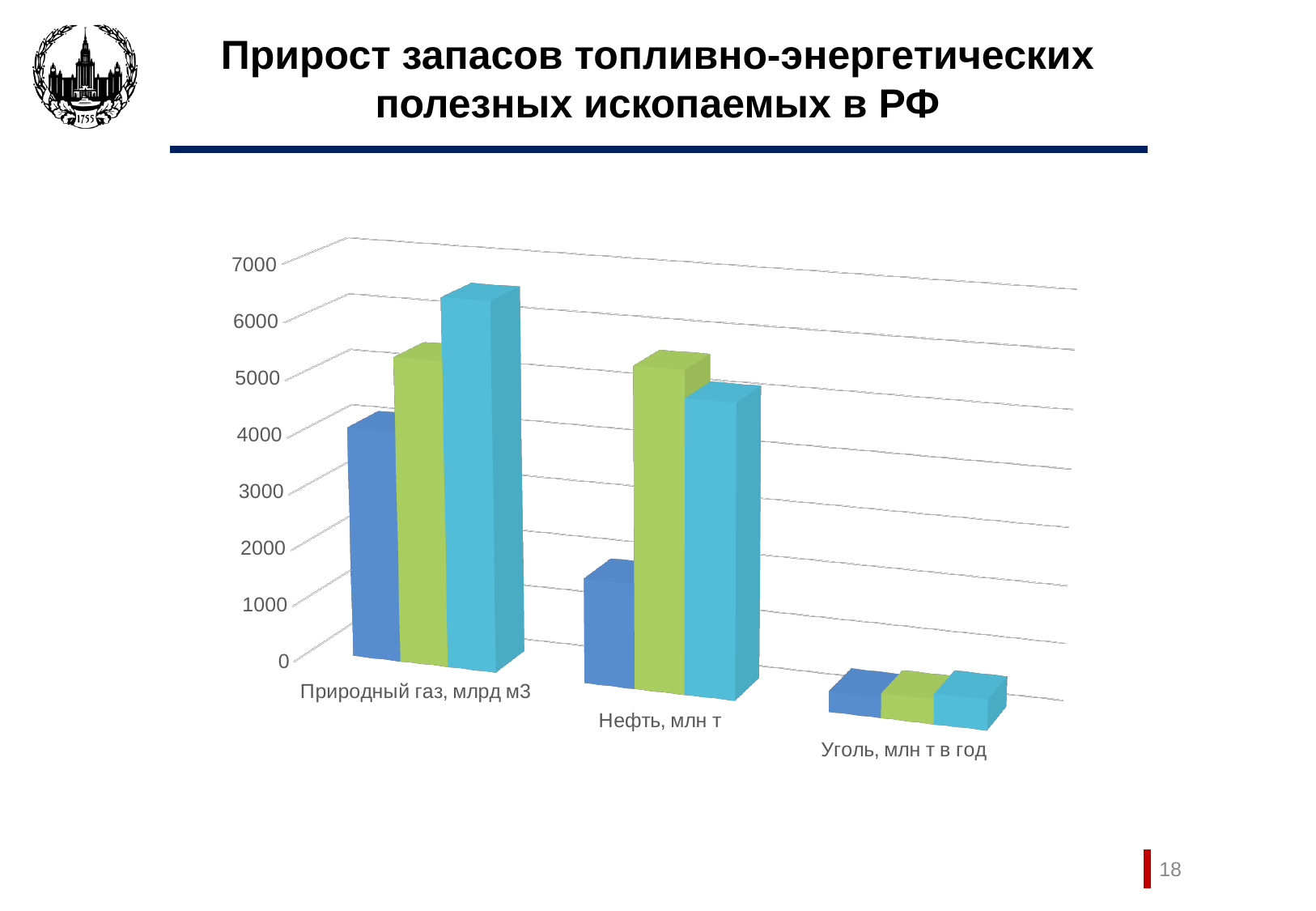
Is the value of the first (blue) bar for Нефть, млн т greater or less than 2000? less Which category has the lowest bars in the chart? Уголь, млн т в год What is the title of the slide containing the chart? Прирост запасов топливно-энергетических полезных ископаемых в РФ How many categories are shown on the x axis of the chart? 3 Is the value of the second (green) bar for Нефть, млн т greater or less than 4000? greater Which is larger: the first (blue) bar for Природный газ, млрд м3 or the first (blue) bar for Нефть, млн т? Природный газ, млрд м3 Are the bars for Уголь, млн т в год greater or less than 1000? less Which category has the tallest bar in the chart? Природный газ, млрд м3 How many bars are plotted for each category in the chart? 3 What kind of chart is shown on the slide? bar chart